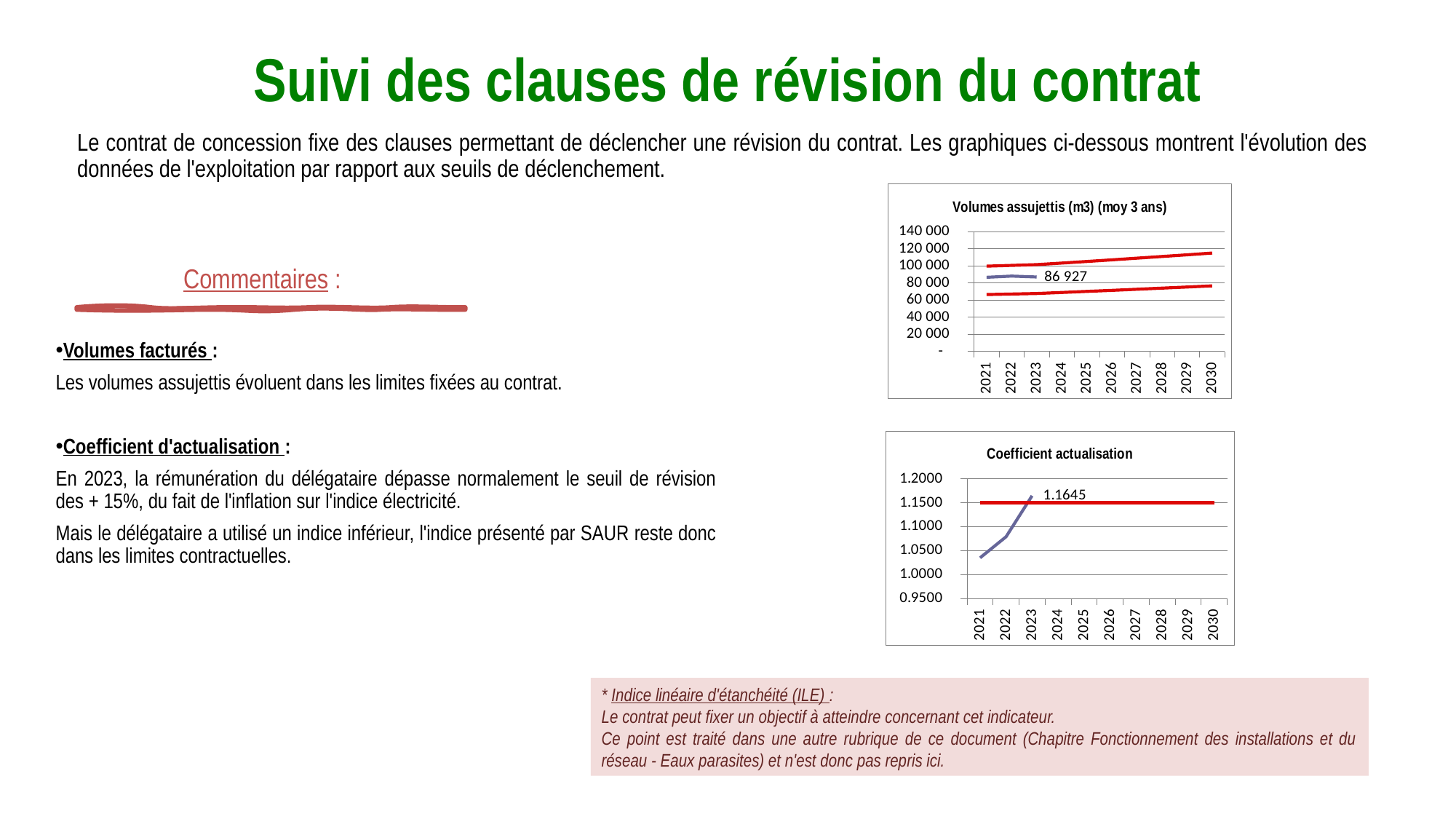
In the 'Volumes assujettis (m3) (moy 3 ans)' chart, is the 2023 value of the blue line greater or less than 100 000? less In the 'Coefficient actualisation' chart, is the 2023 value of the blue line greater or less than 1.1500? greater In the 'Volumes assujettis (m3) (moy 3 ans)' chart, is the lower red line in 2021 greater or less than 80 000? less How many years are shown on the x axis of the 'Volumes assujettis (m3) (moy 3 ans)' chart? 10 In the 'Coefficient actualisation' chart, at which axis level does the horizontal red line sit? 1.1500 What is the title of the top chart on the slide? Volumes assujettis (m3) (moy 3 ans) What kind of chart is the 'Coefficient actualisation' chart? line chart In the 'Coefficient actualisation' chart, what value is labelled on the blue line for 2023? 1.1645 In the 'Coefficient actualisation' chart, does the blue line rise or fall from 2021 to 2023? rise In the 'Volumes assujettis (m3) (moy 3 ans)' chart, what value is labelled on the blue line for 2023? 86 927 What kind of chart is the 'Volumes assujettis (m3) (moy 3 ans)' chart? line chart